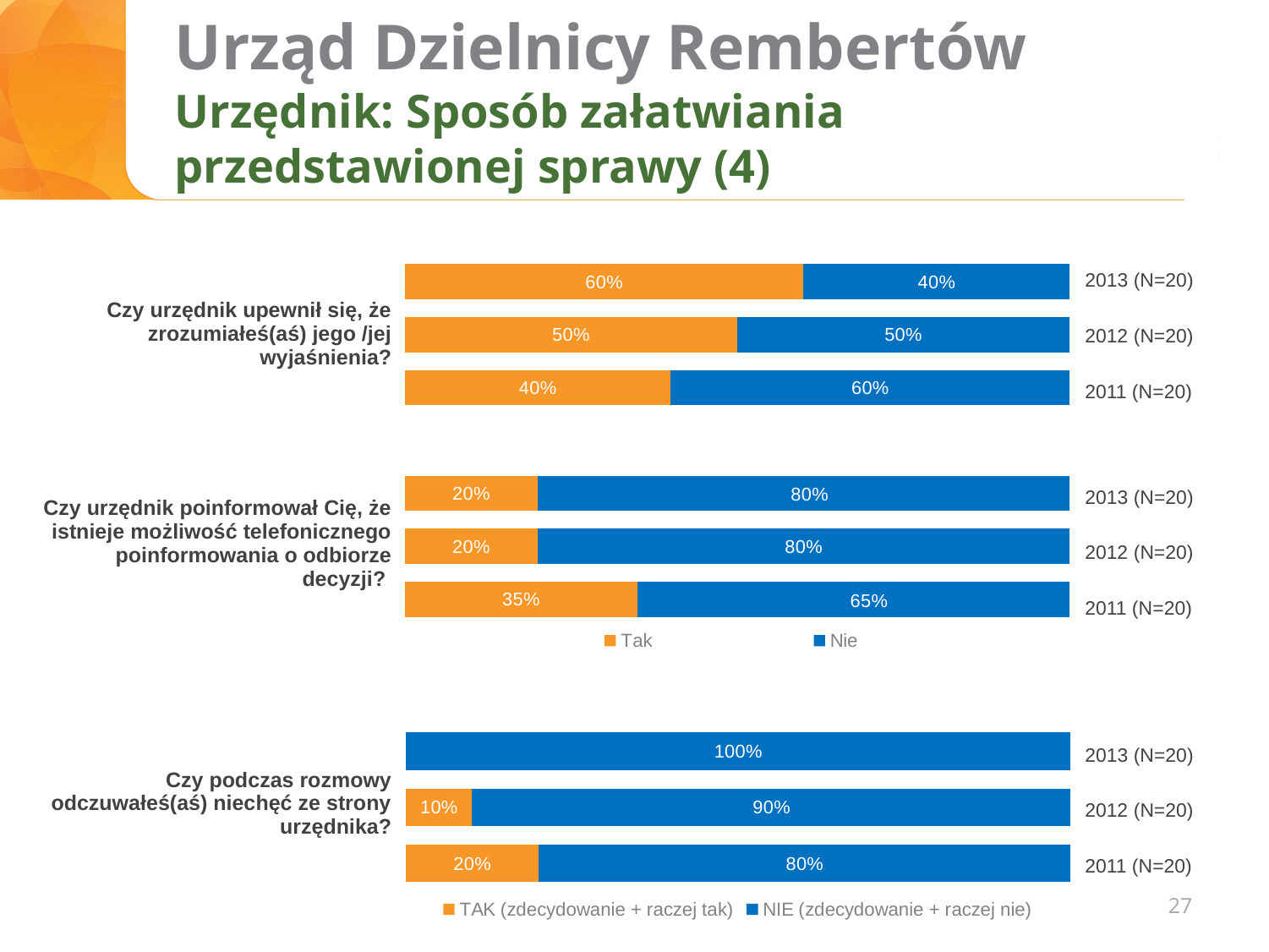
In the chart for "Czy urzędnik upewnił się, że zrozumiałeś(aś) jego /jej wyjaśnienia?", does the Tak share rise or fall from 2011 to 2013? rise In the chart for "Czy urzędnik upewnił się, że zrozumiałeś(aś) jego /jej wyjaśnienia?", what is the Nie share for 2011 (N=20)? 60% In the chart for "Czy podczas rozmowy odczuwałeś(aś) niechęć ze strony urzędnika?", what is the NIE share for 2013 (N=20)? 100% In the chart for "Czy urzędnik poinformował Cię, że istnieje możliwość telefonicznego poinformowania o odbiorze decyzji?", what is the difference between the Nie and Tak shares in 2011? 30% In the chart for "Czy podczas rozmowy odczuwałeś(aś) niechęć ze strony urzędnika?", is the TAK share for 2011 larger or smaller than the TAK share for 2012? larger In the chart for "Czy urzędnik upewnił się, że zrozumiałeś(aś) jego /jej wyjaśnienia?", what is the Tak share for 2013 (N=20)? 60% What type of chart is used on the slide? Stacked horizontal bar chart In the chart for "Czy podczas rozmowy odczuwałeś(aś) niechęć ze strony urzędnika?", what is the TAK share for 2012 (N=20)? 10% How many years (bars) are shown in each of the three charts on the slide? 3 In the chart for "Czy urzędnik poinformował Cię, że istnieje możliwość telefonicznego poinformowania o odbiorze decyzji?", what is the Tak share for 2011 (N=20)? 35% In the chart for "Czy podczas rozmowy odczuwałeś(aś) niechęć ze strony urzędnika?", which year has the lowest NIE share? 2011 (N=20) In the chart for "Czy urzędnik poinformował Cię, że istnieje możliwość telefonicznego poinformowania o odbiorze decyzji?", which year has the highest Nie share? 2013 and 2012 (both 80%)